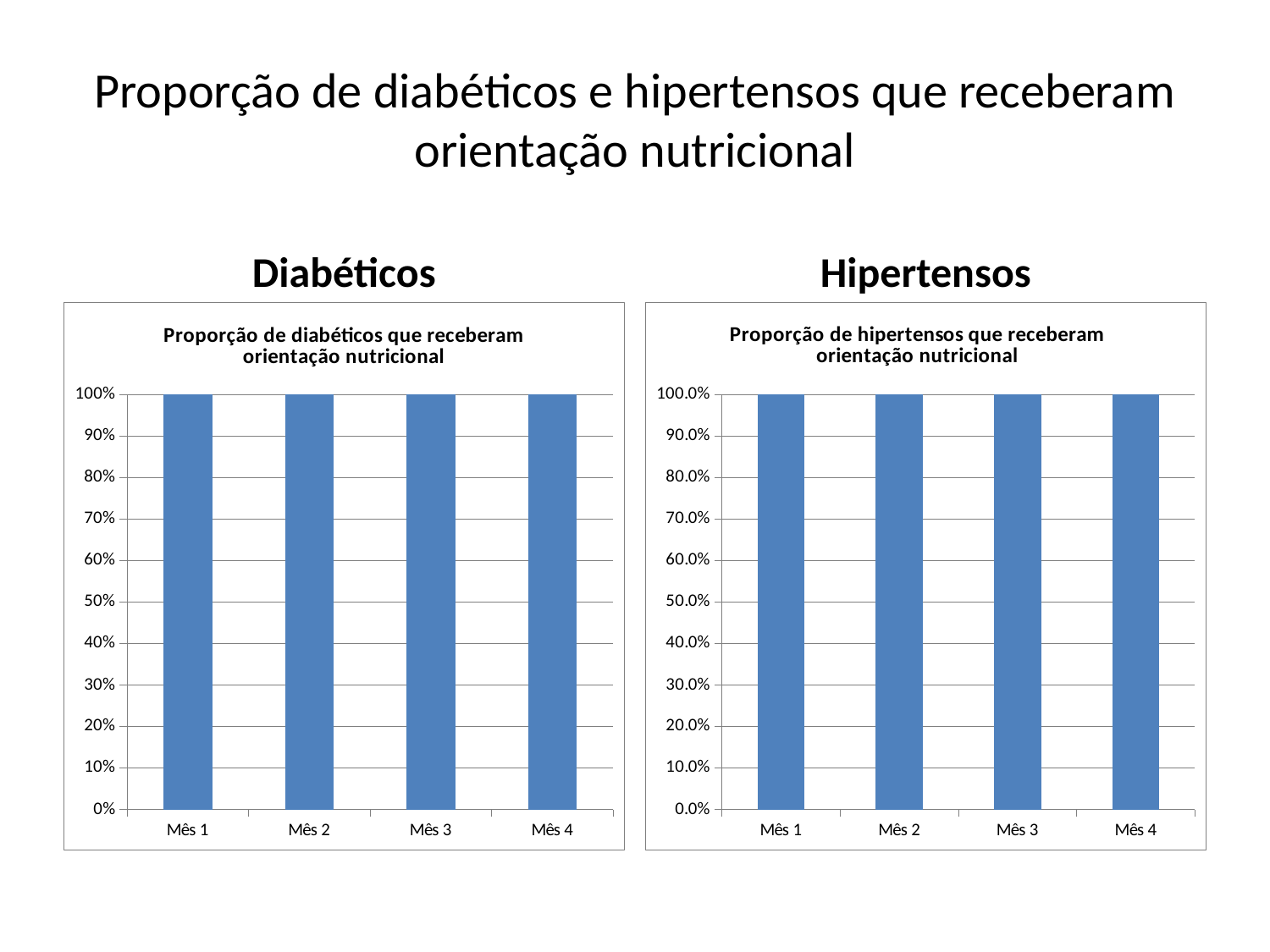
In the Hipertensos chart, what is the value for Mês 2? 100.0% How many bars are plotted in the Hipertensos chart? 4 In the Diabéticos chart, do the values rise, fall, or stay the same from Mês 1 to Mês 4? Stay the same In the Diabéticos chart, what is the value for Mês 4? 100% In the Hipertensos chart, is the value for Mês 1 greater or less than 50.0%? greater What kind of chart is the Hipertensos chart? Bar chart What is the title printed inside the Hipertensos chart? Proporção de hipertensos que receberam orientação nutricional In the Diabéticos chart, what is the value for Mês 1? 100% How many categories are shown on the x axis of the Diabéticos chart? 4 What kind of chart is the Diabéticos chart? Bar chart In the Hipertensos chart, what is the value for Mês 3? 100.0% In the Diabéticos chart, what is the difference between the values for Mês 2 and Mês 3? 0%